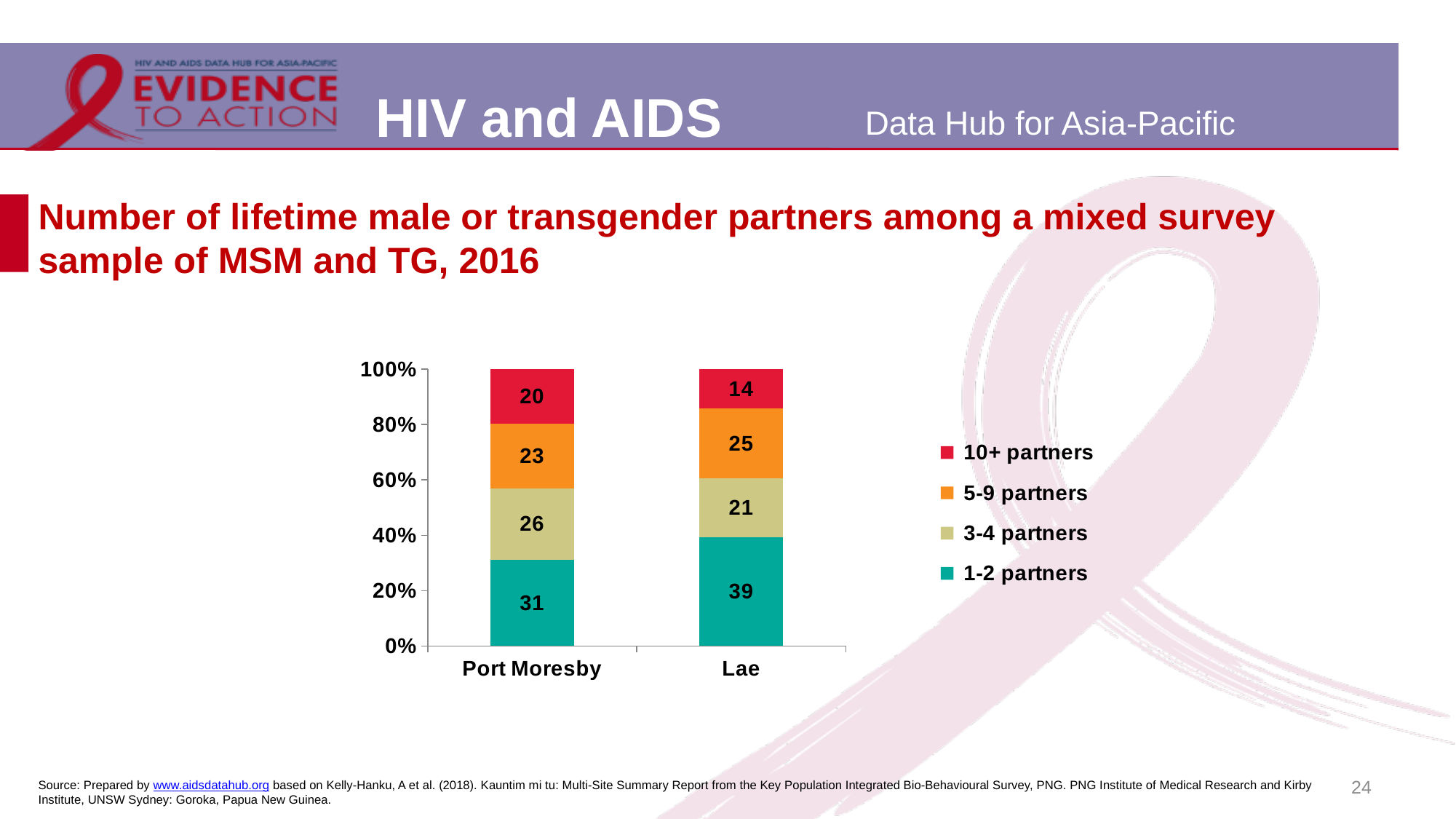
What is the value for 3-4 partners in Port Moresby? 26 What is the value for 1-2 partners in Port Moresby? 31 What is the difference between the 1-2 partners values for Lae and Port Moresby? 8 Which category has the higher value for 1-2 partners, Port Moresby or Lae? Lae What is the value for 10+ partners in Lae? 14 Which series has the largest value in the Port Moresby bar? 1-2 partners Which series has the smallest value in the Lae bar? 10+ partners What is the difference between the 10+ partners values for Port Moresby and Lae? 6 What is the value for 5-9 partners in Lae? 25 How many series does the legend list? 4 How many categories are shown on the x axis of the chart? 2 What kind of chart is shown on the slide? Stacked bar chart